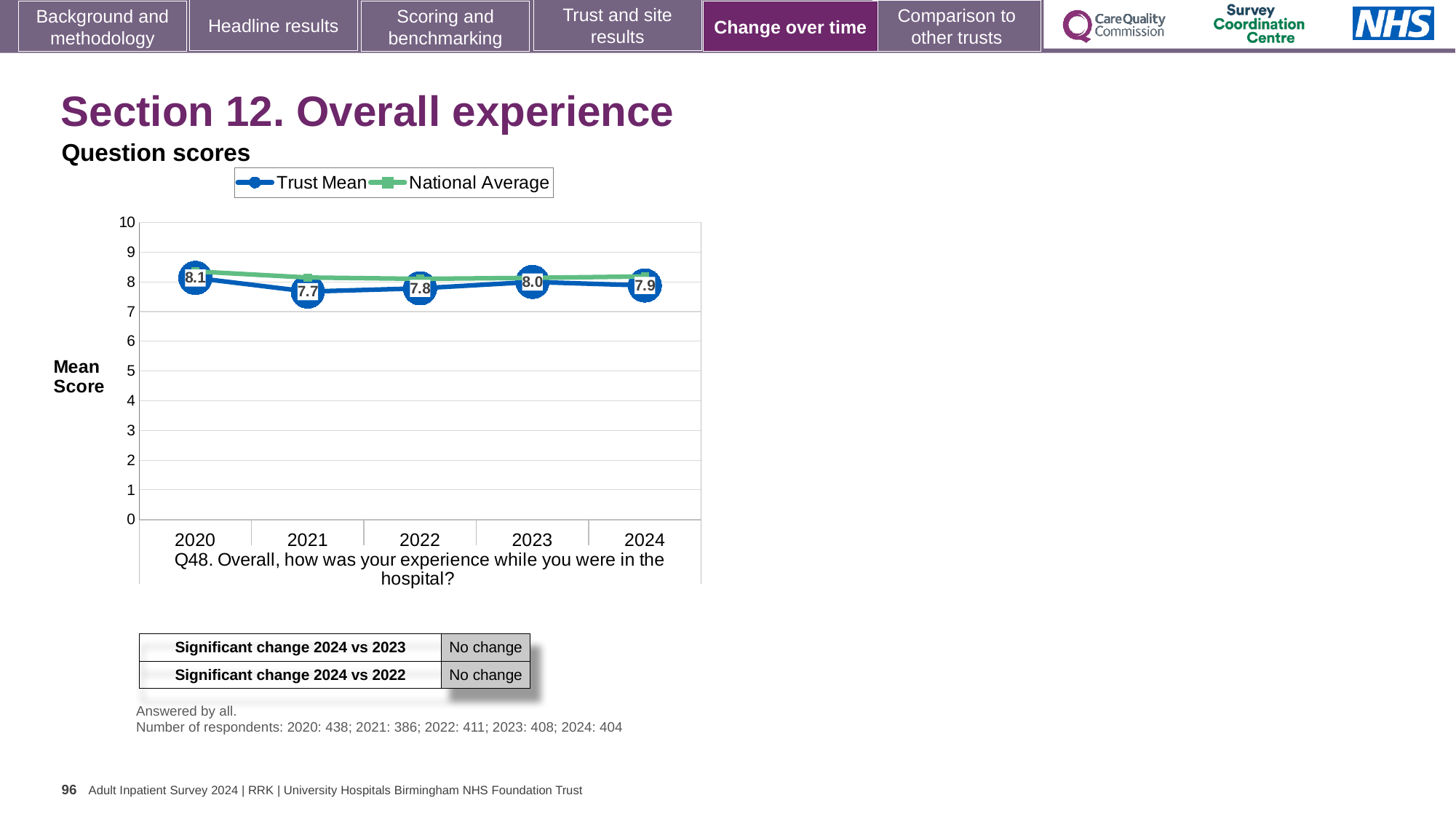
What is the Trust Mean score for 2024? 7.9 In which year is the Trust Mean score lowest? 2021 How many series does the chart legend list? 2 What is the difference between the Trust Mean scores for 2020 and 2021? 0.4 Which is larger, the Trust Mean score for 2023 or for 2022? 2023 Is the National Average value for 2021 greater or less than 8? greater In which year is the Trust Mean score highest? 2020 Which series is shown in green in the chart? National Average What is the Trust Mean score for 2020? 8.1 What kind of chart is shown on the slide? Line chart What is the Trust Mean score for 2021? 7.7 How many years are shown on the x axis of the chart? 5